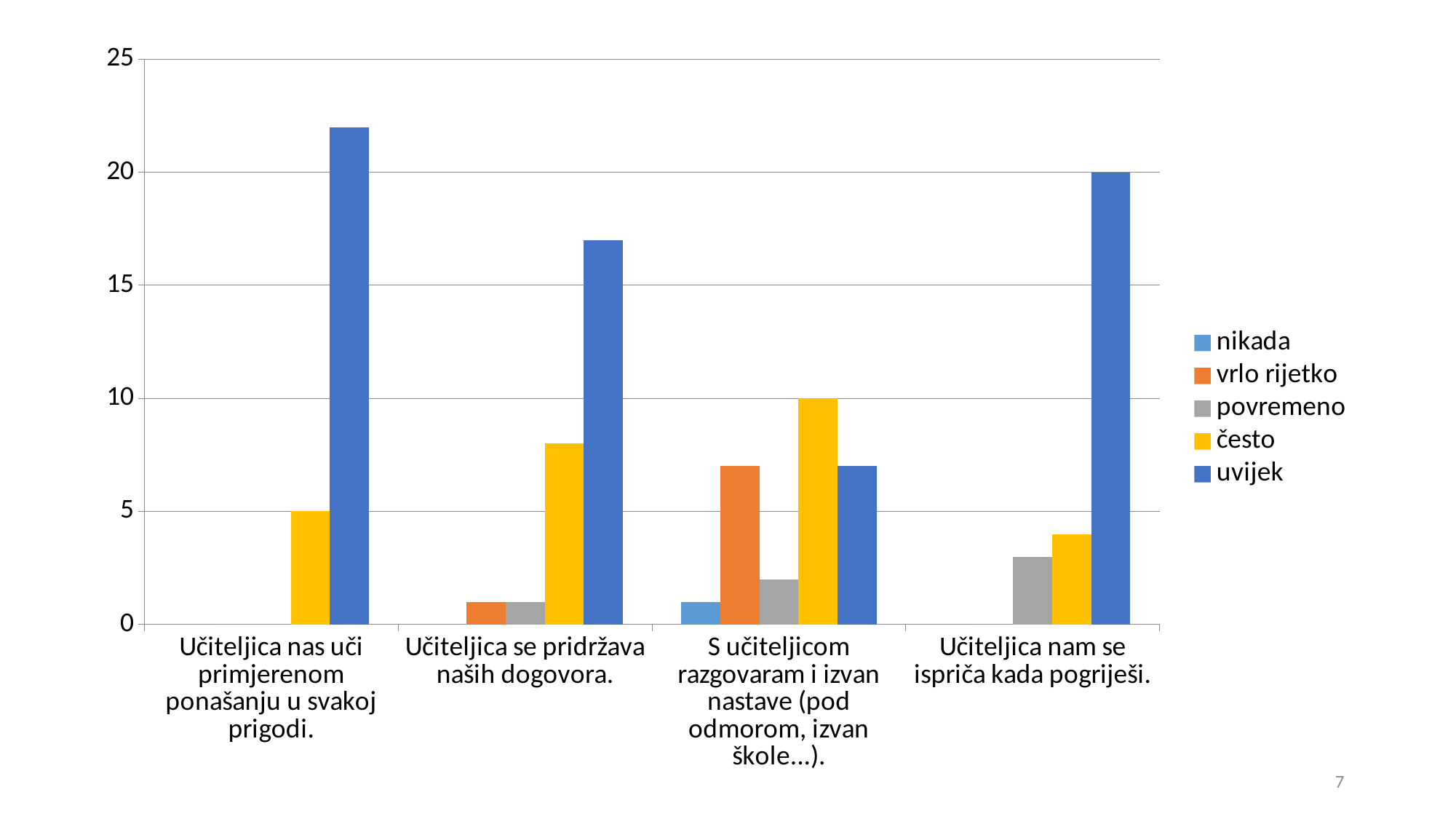
How many series does the legend list? 5 What kind of chart is shown on the slide? bar chart Which category has the highest "uvijek" value? Učiteljica nas uči primjerenom ponašanju u svakoj prigodi. What is the value of "često" for "S učiteljicom razgovaram i izvan nastave (pod odmorom, izvan škole…)."? 10 Which series is shown in yellow in the legend? često Is the "uvijek" value for "Učiteljica se pridržava naših dogovora." greater or less than 15? greater What is the value of "uvijek" for "Učiteljica nam se ispriča kada pogriješi."? 20 For "S učiteljicom razgovaram i izvan nastave (pod odmorom, izvan škole…).", which is larger: "često" or "uvijek"? često Which category has the lowest "uvijek" value? S učiteljicom razgovaram i izvan nastave (pod odmorom, izvan škole…). How many categories are shown on the x axis? 4 Is the "uvijek" value for "Učiteljica nas uči primjerenom ponašanju u svakoj prigodi." greater or less than 20? greater What is the value of "često" for "Učiteljica nas uči primjerenom ponašanju u svakoj prigodi."? 5